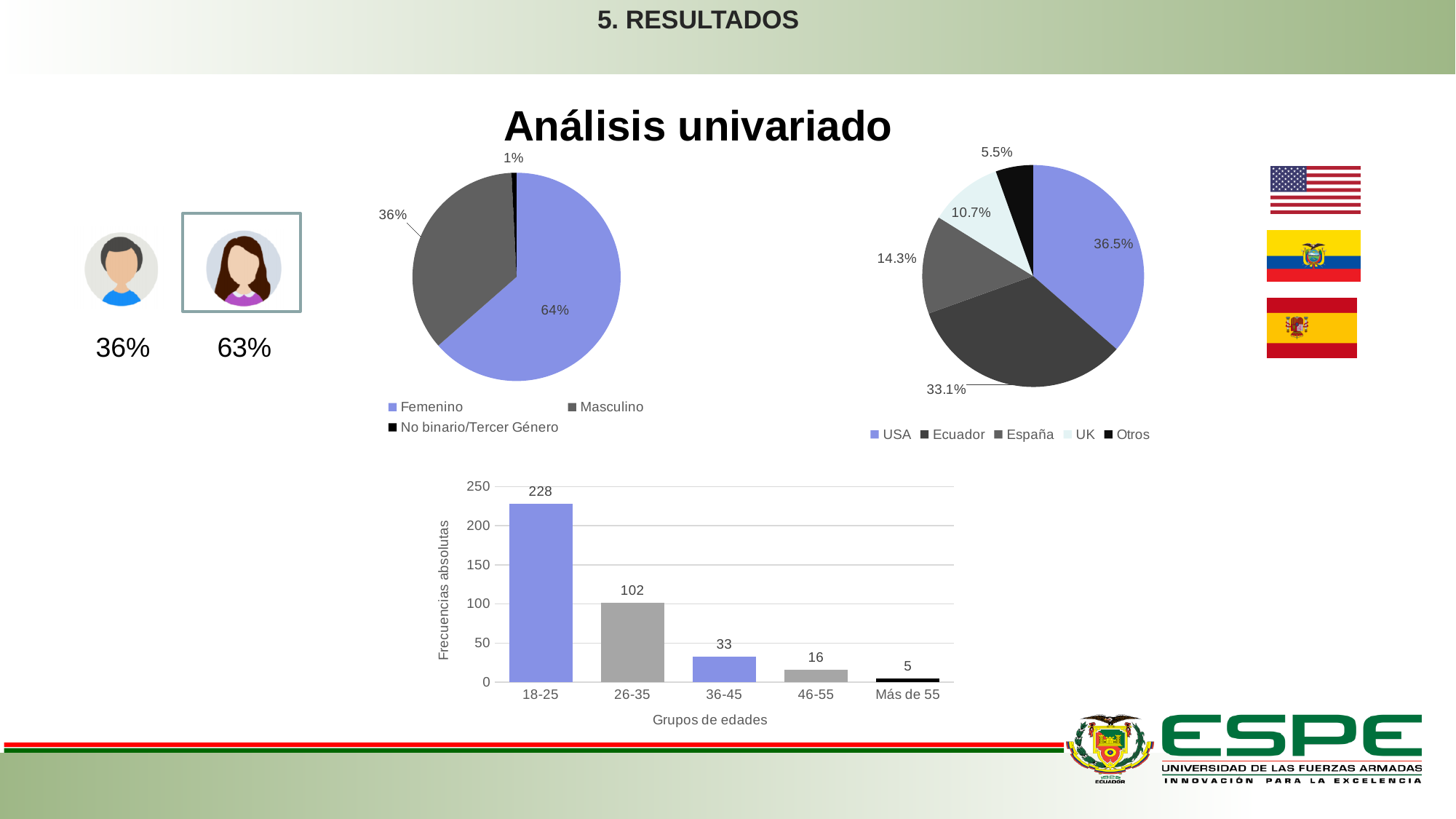
In the country pie chart on the right, which category has the smallest share? Otros In the gender pie chart on the left, what share is No binario/Tercer Género? 1% In the country pie chart on the right, what is the difference between the shares of España and UK? 3.6% What type of chart is shown at the bottom of the slide? bar chart In the country pie chart on the right, which country has the largest share? USA In the bar chart at the bottom, do the values rise or fall from left to right along the x axis? fall In the gender pie chart on the left, how many categories does the legend list? 3 In the bar chart at the bottom, which age group has the highest frequency? 18-25 In the country pie chart on the right, what share is Ecuador? 33.1% In the bar chart at the bottom, what is the value for the 26-35 age group? 102 In the bar chart at the bottom, what is the difference between the 18-25 and 26-35 groups? 126 In the gender pie chart on the left, what share is Femenino? 64%